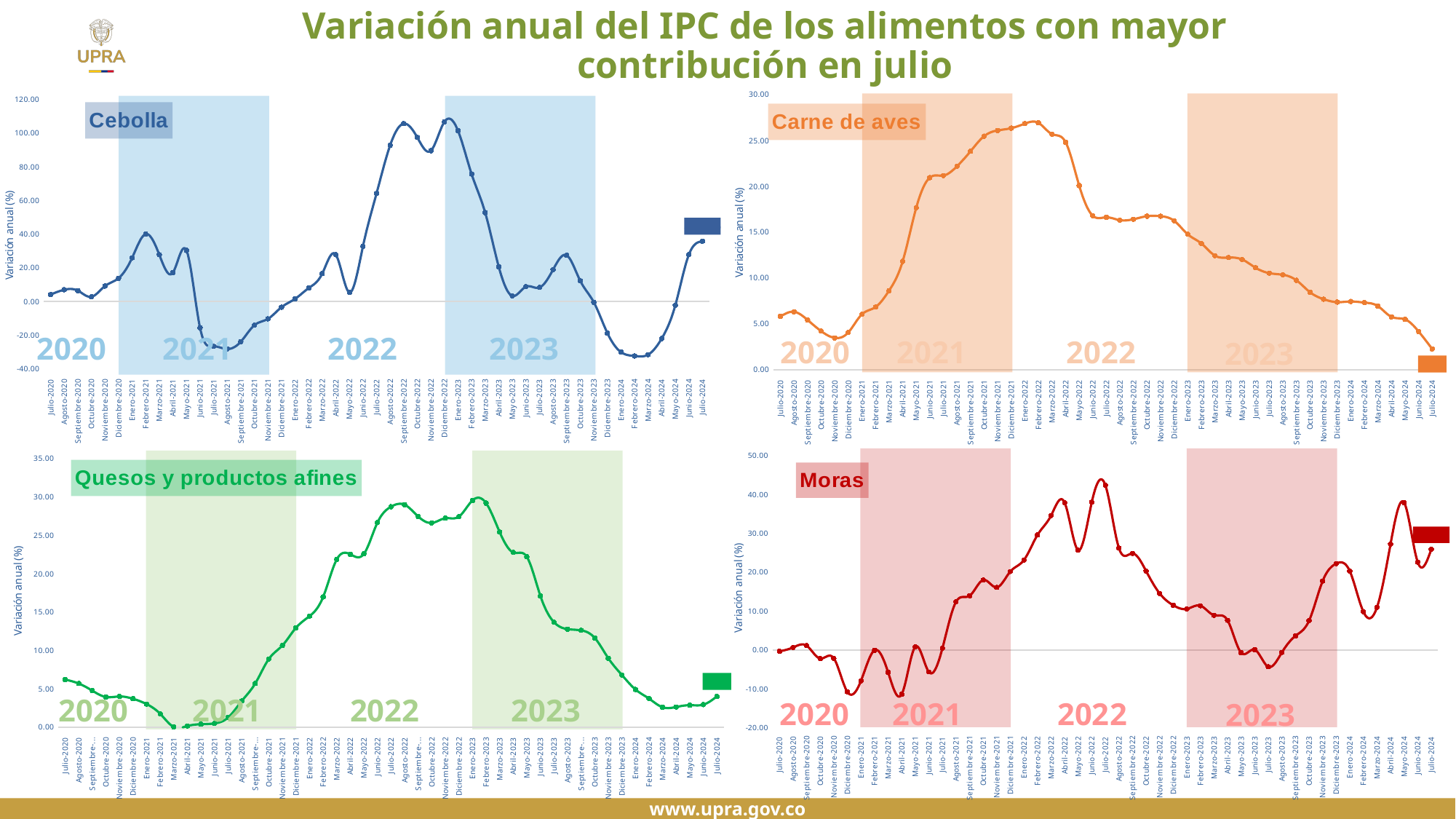
In the Carne de aves chart, is the value for Julio-2024 greater or less than 5.00? less In the Carne de aves chart, does the value rise or fall from Febrero-2022 to Julio-2024? fall In the Carne de aves chart, is the value for Febrero-2022 greater or less than 25.00? greater In the Quesos y productos afines chart, is the value for Enero-2023 greater or less than 25.00? greater What kind of chart is used for the Cebolla panel? Line chart What is the y-axis label on the Moras chart? Variación anual (%) In the Moras chart, which is larger, the value for Julio-2020 or the value for Julio-2024? Julio-2024 What is the title of the slide? Variación anual del IPC de los alimentos con mayor contribución en julio How many charts are shown on the slide? 4